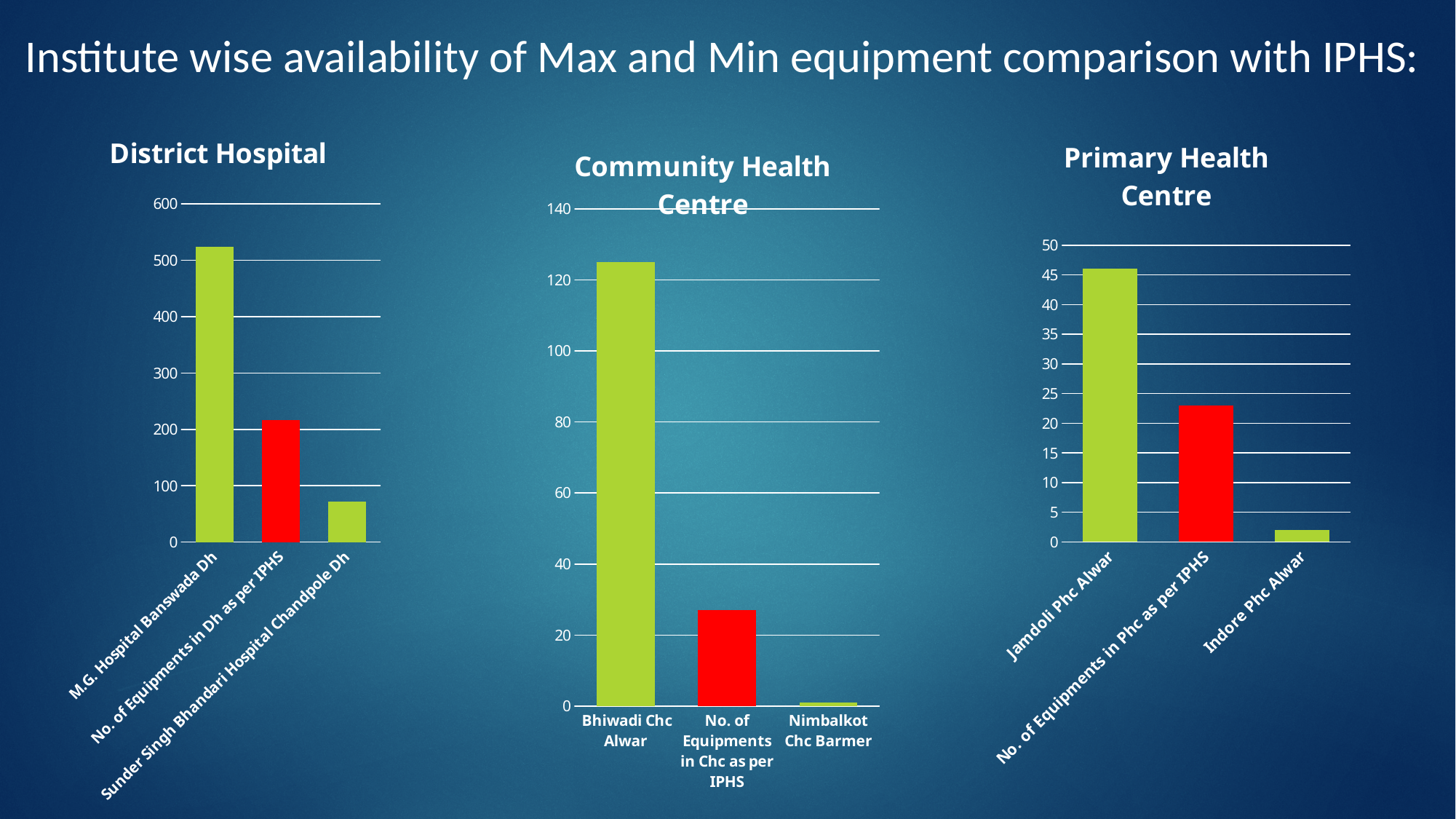
In the District Hospital chart, is the value for M.G. Hospital Banswada Dh greater or less than 500? greater In the District Hospital chart, is the value for Sunder Singh Bhandari Hospital Chandpole Dh greater or less than 100? less How many categories are shown in the Community Health Centre chart? 3 In the Community Health Centre chart, is the value for No. of Equipments in Chc as per IPHS greater or less than 40? less In the Community Health Centre chart, which category has the highest value? Bhiwadi Chc Alwar In the Community Health Centre chart, which category has the lowest value? Nimbalkot Chc Barmer What kind of chart is the Primary Health Centre chart? Bar chart In the Primary Health Centre chart, which category has the highest value? Jamdoli Phc Alwar In the Primary Health Centre chart, which is larger: the value for No. of Equipments in Phc as per IPHS or the value for Indore Phc Alwar? No. of Equipments in Phc as per IPHS In the District Hospital chart, which category has the highest value? M.G. Hospital Banswada Dh In the District Hospital chart, which category has the lowest value? Sunder Singh Bhandari Hospital Chandpole Dh